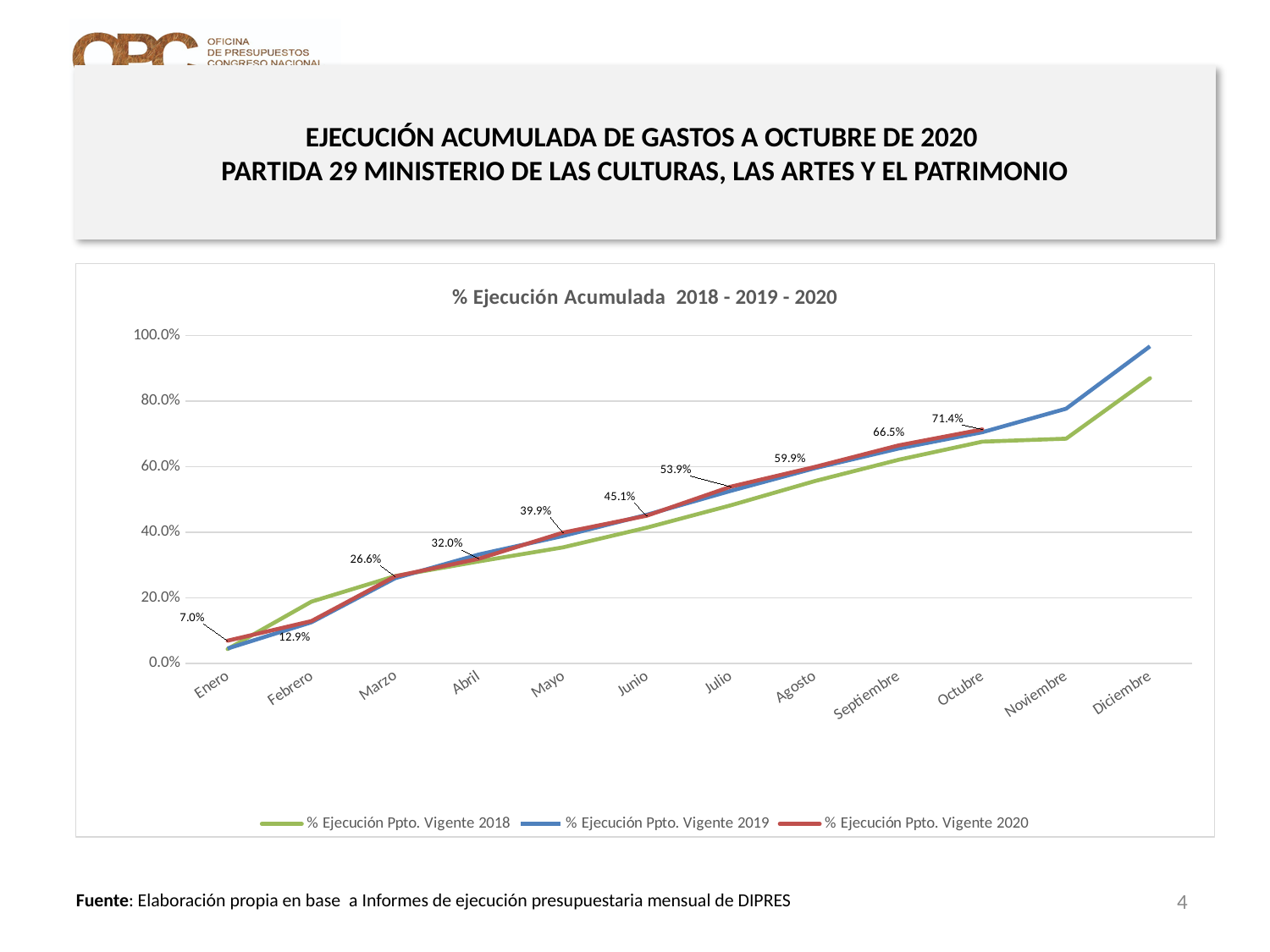
What is the value for % Ejecución Ppto. Vigente 2020 in Enero? 7.0% In Diciembre, which series is higher: % Ejecución Ppto. Vigente 2018 or % Ejecución Ppto. Vigente 2019? % Ejecución Ppto. Vigente 2019 In which month is the % Ejecución Ppto. Vigente 2020 series lowest? Enero How many months are shown on the x axis? 12 What is the difference between the 2020 values for Julio and Junio? 8.8% Is the value for % Ejecución Ppto. Vigente 2019 in Diciembre greater or less than 80.0%? greater What is the difference between the 2020 values for Octubre and Septiembre? 4.9% How many series does the legend list? 3 In which month is the % Ejecución Ppto. Vigente 2020 series highest? Octubre What is the value for % Ejecución Ppto. Vigente 2020 in Octubre? 71.4% What is the value for % Ejecución Ppto. Vigente 2020 in Junio? 45.1% What kind of chart is shown on the slide? line chart